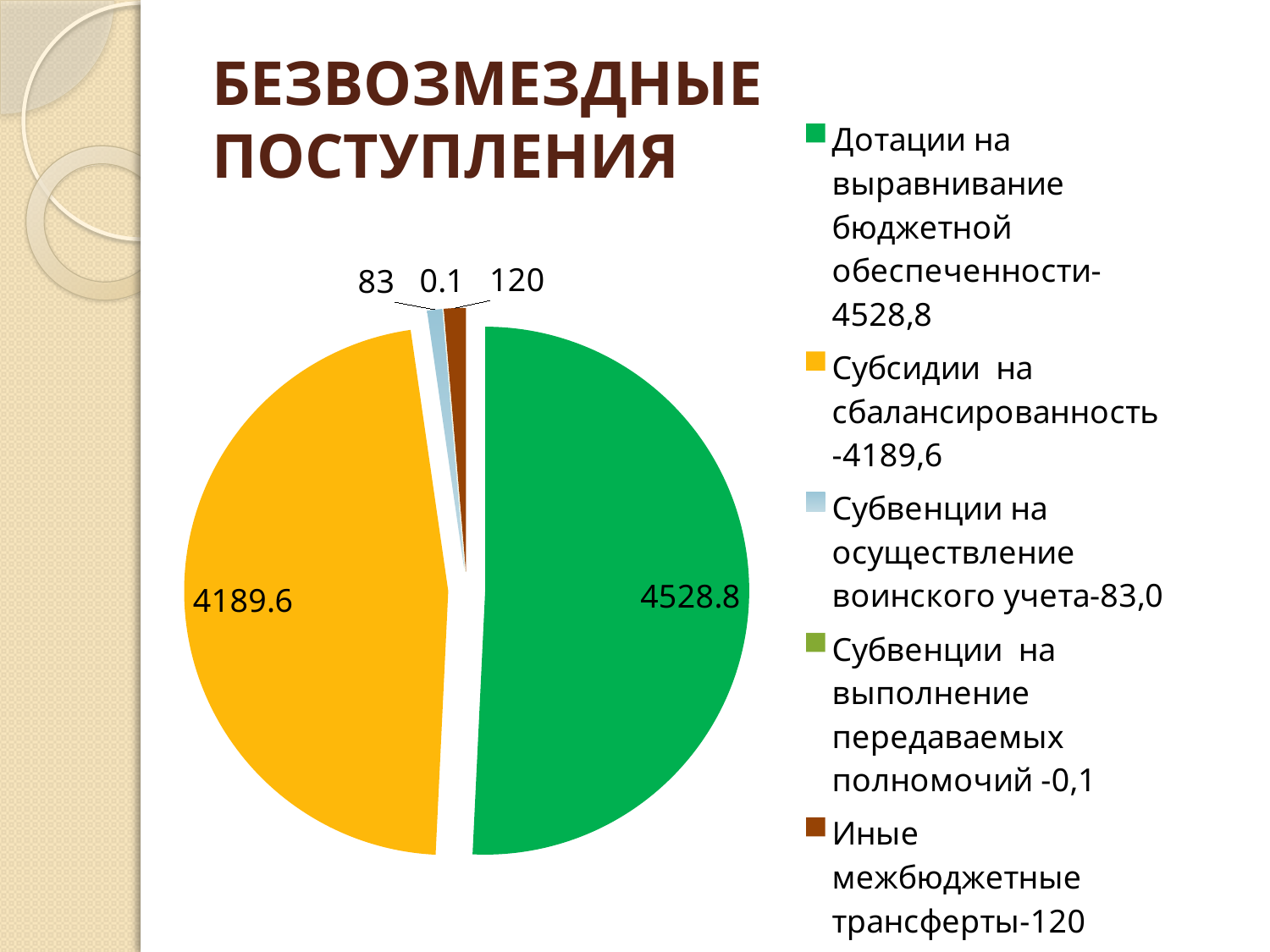
What is the value of the slice for Дотации на выравнивание бюджетной обеспеченности? 4528.8 What is the value of the slice for Иные межбюджетные трансферты? 120 Which category has the largest slice of the pie? Дотации на выравнивание бюджетной обеспеченности What is the value of the slice for Субсидии на сбалансированность? 4189.6 What kind of chart is shown on the slide? pie chart What colour is the slice for Субсидии на сбалансированность? yellow What is the value of the slice for Субвенции на осуществление воинского учета? 83 Which category has the smallest slice of the pie? Субвенции на выполнение передаваемых полномочий How many slices does the pie chart have? 5 Which is larger: the slice for Иные межбюджетные трансферты or the slice for Субвенции на осуществление воинского учета? Иные межбюджетные трансферты What is the difference between the values for Дотации на выравнивание бюджетной обеспеченности and Субсидии на сбалансированность? 339.2 What is the value of the slice for Субвенции на выполнение передаваемых полномочий? 0.1